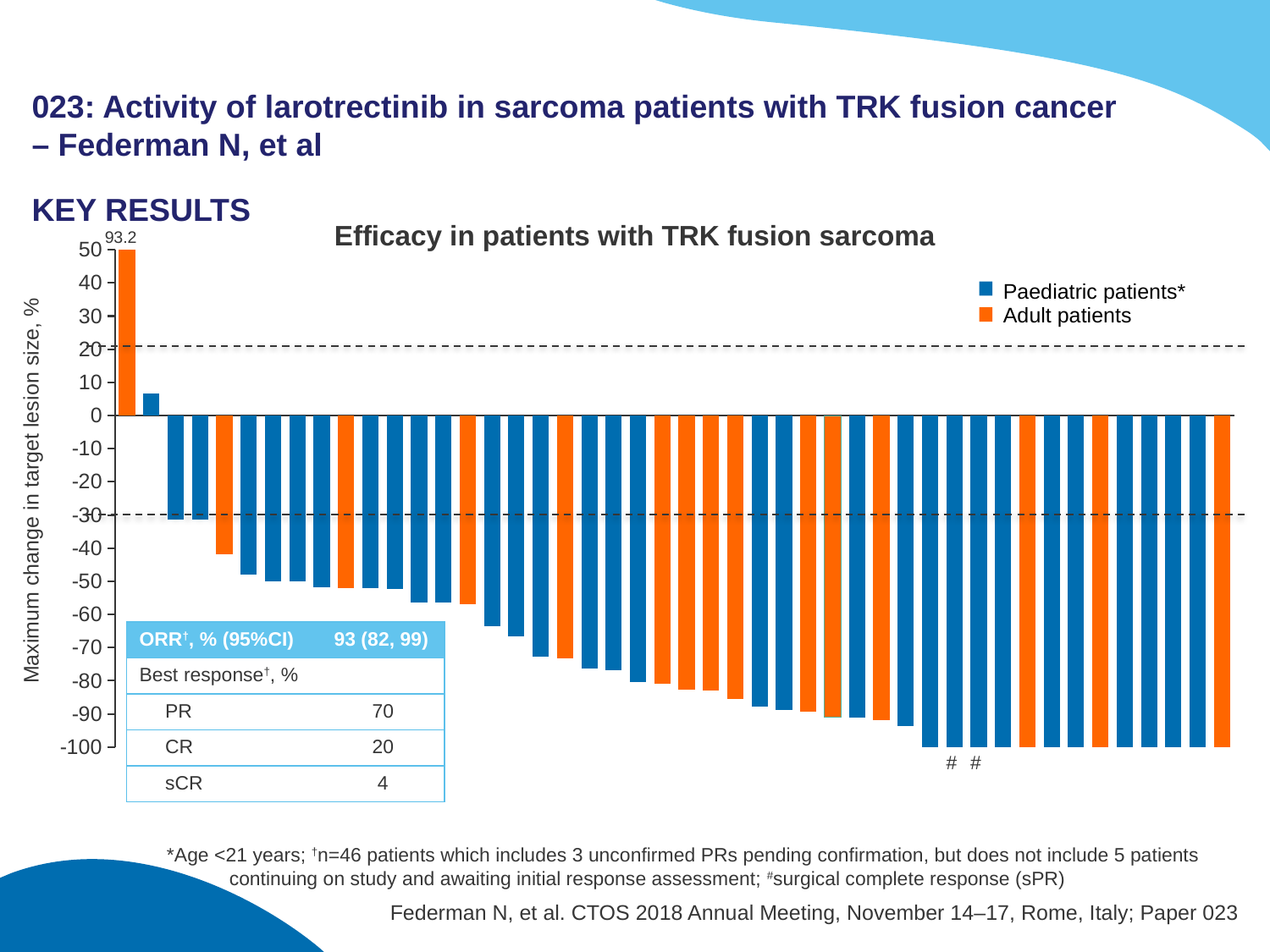
Which series does the highest bar in the chart belong to? Adult patients Is the value of the rightmost bar greater or less than -90? less What kind of chart is shown on the slide? Bar chart How many series does the chart legend list? 2 What are the two series named in the chart legend? Paediatric patients* and Adult patients Moving from left to right along the chart, do the bar values rise or fall? fall What is the label of the chart's vertical axis? Maximum change in target lesion size, % Is the value of the leftmost bar greater or less than 50? greater Is the value of the first orange bar below zero (the fifth bar from the left) greater or less than -30? less What value is printed above the leftmost bar of the chart? 93.2 Which is larger, the leftmost orange bar or the blue bar immediately to its right? The leftmost orange bar